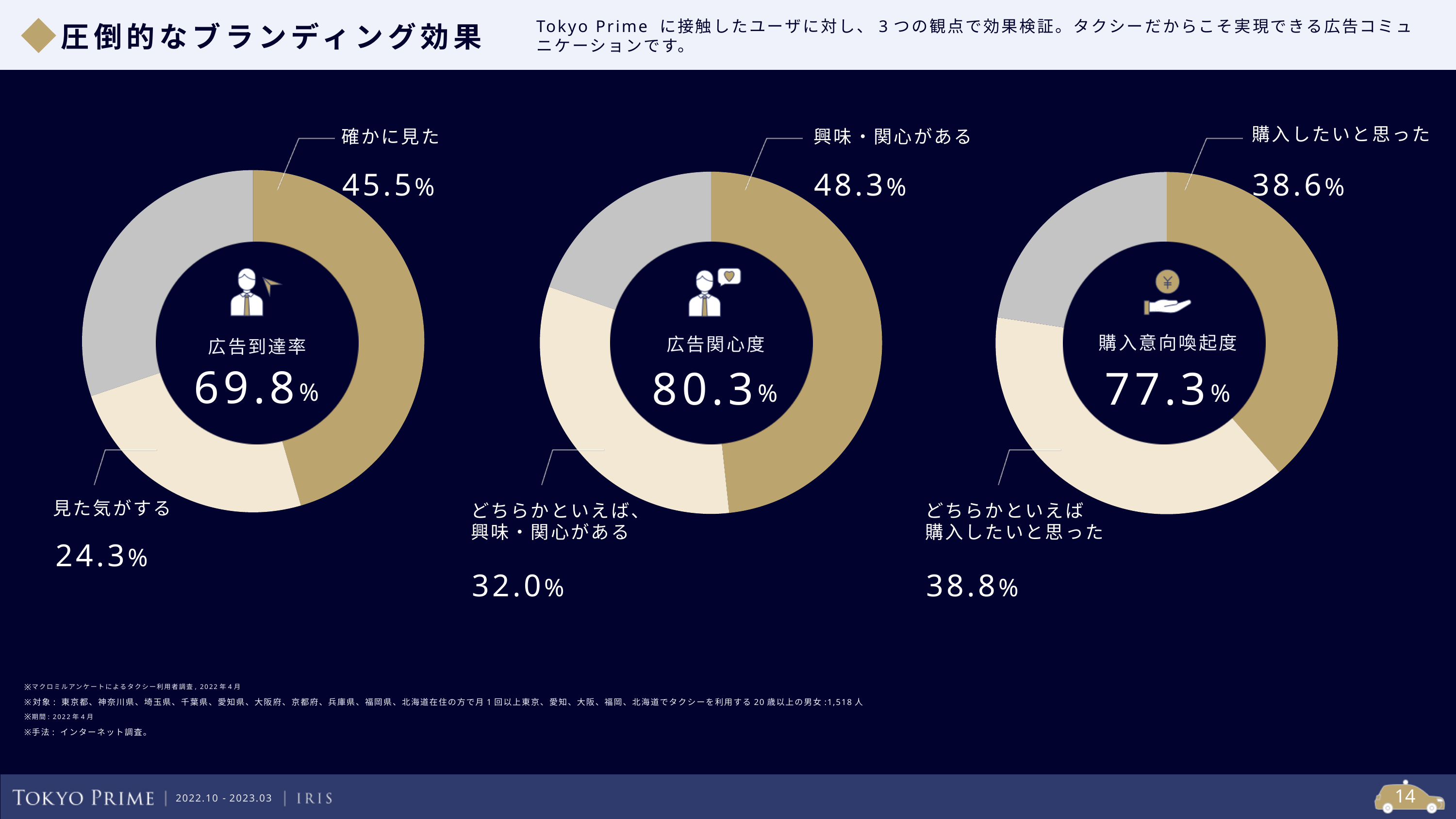
In the 広告到達率 chart (left), what is the combined share of 確かに見た and 見た気がする? 69.8% What overall value is shown in the centre of the 広告関心度 chart (middle)? 80.3% In the 購入意向喚起度 chart (right), what percentage is labelled for 購入したいと思った? 38.6% What kind of chart is used for the three metrics on this slide? Donut (pie) chart In the 広告関心度 chart (middle), what percentage is labelled for どちらかといえば、興味・関心がある? 32.0% In the 広告到達率 chart (left), what percentage is labelled for 確かに見た? 45.5% In the 広告関心度 chart (middle), what percentage is labelled for 興味・関心がある? 48.3% In the 広告到達率 chart (left), which is larger: 確かに見た or 見た気がする? 確かに見た In the 広告関心度 chart (middle), what is the difference between 興味・関心がある and どちらかといえば、興味・関心がある? 16.3% In the 広告到達率 chart (left), what percentage is labelled for 見た気がする? 24.3% Which of the three charts shows the highest centre value? 広告関心度 In the 購入意向喚起度 chart (right), what percentage is labelled for どちらかといえば購入したいと思った? 38.8%